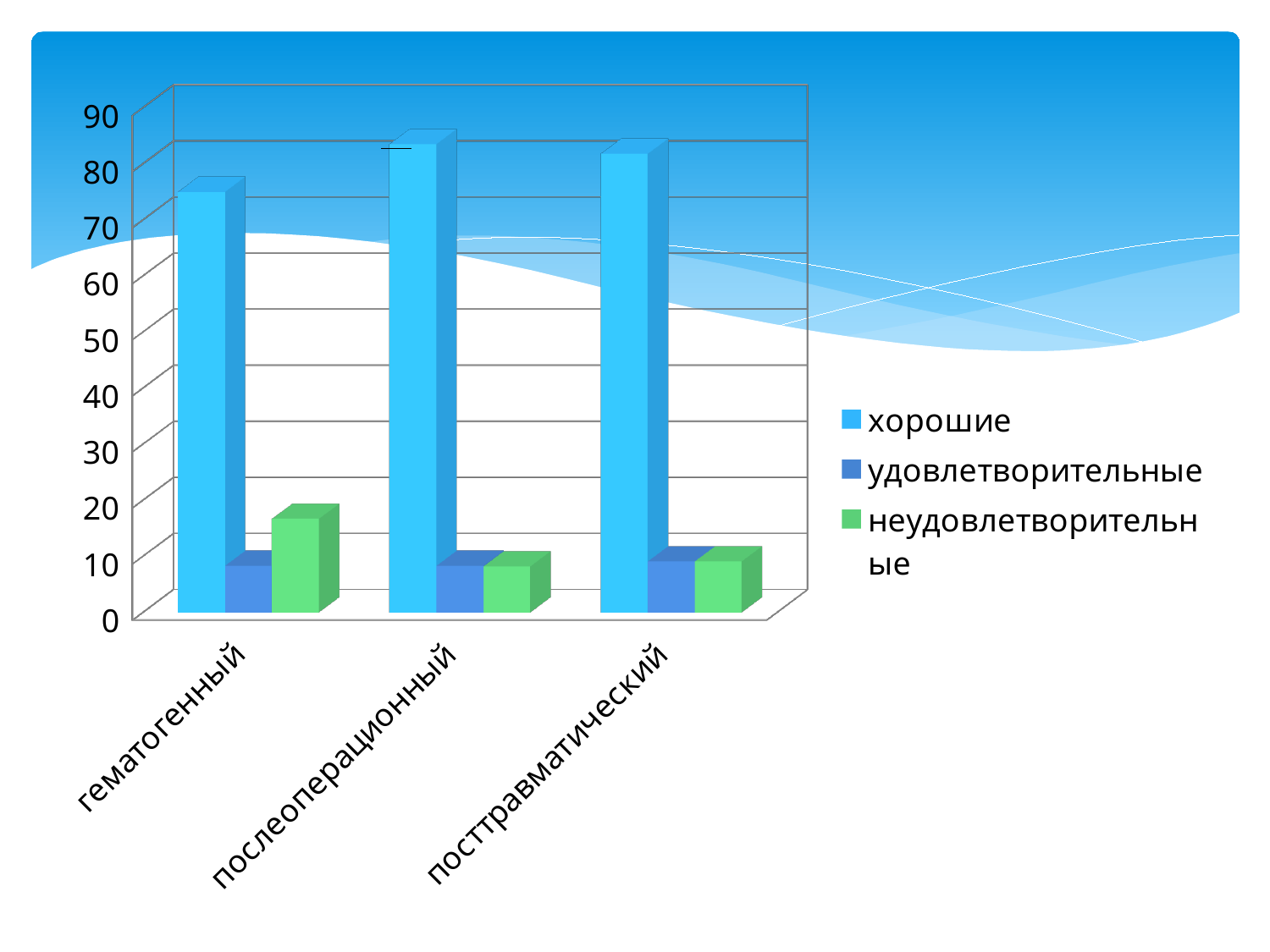
What kind of chart is shown on the slide? bar chart Which is larger: неудовлетворительные for гематогенный or неудовлетворительные for послеоперационный? гематогенный Is the value of удовлетворительные for послеоперационный greater or less than 20? less How many series does the legend list? 3 Is the value of хорошие for гематогенный greater or less than 70? greater Which series is shown in green in the legend? неудовлетворительные How many categories are shown on the x axis? 3 Is the value of хорошие for гематогенный greater or less than 80? less Which category has the lowest value for хорошие? гематогенный